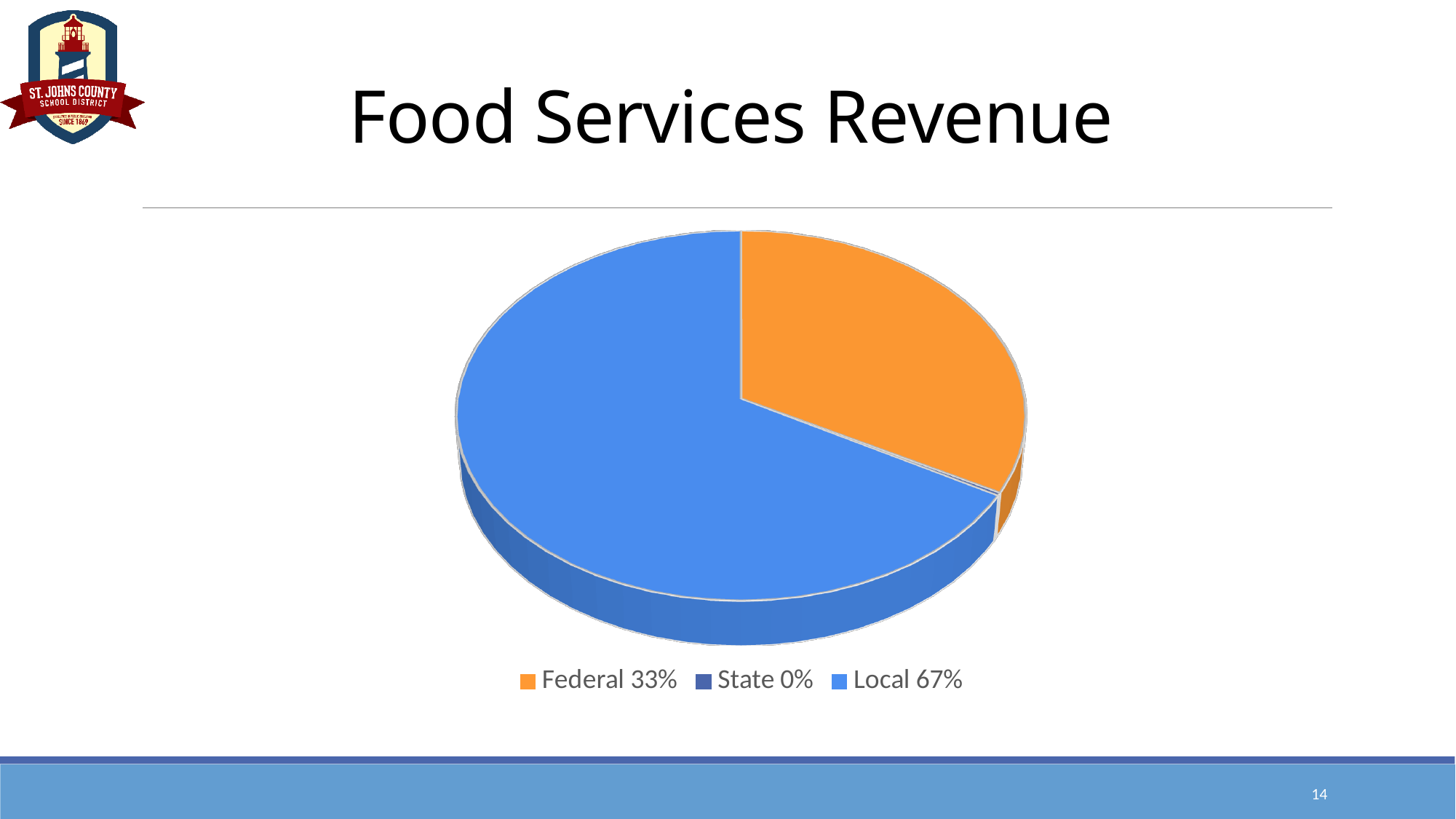
Which revenue source has the largest share of Food Services Revenue? Local What colour represents the Federal slice? Orange Which revenue source has the smallest share of Food Services Revenue? State What kind of chart is shown on the slide? Pie chart How many revenue sources are listed in the legend? 3 What share of Food Services Revenue comes from State sources? 0% What share of Food Services Revenue comes from Federal sources? 33% What share of Food Services Revenue comes from Local sources? 67% What is the title of the chart? Food Services Revenue Which is larger, the Federal share or the Local share? Local What is the difference in percentage points between the Local and Federal shares? 34